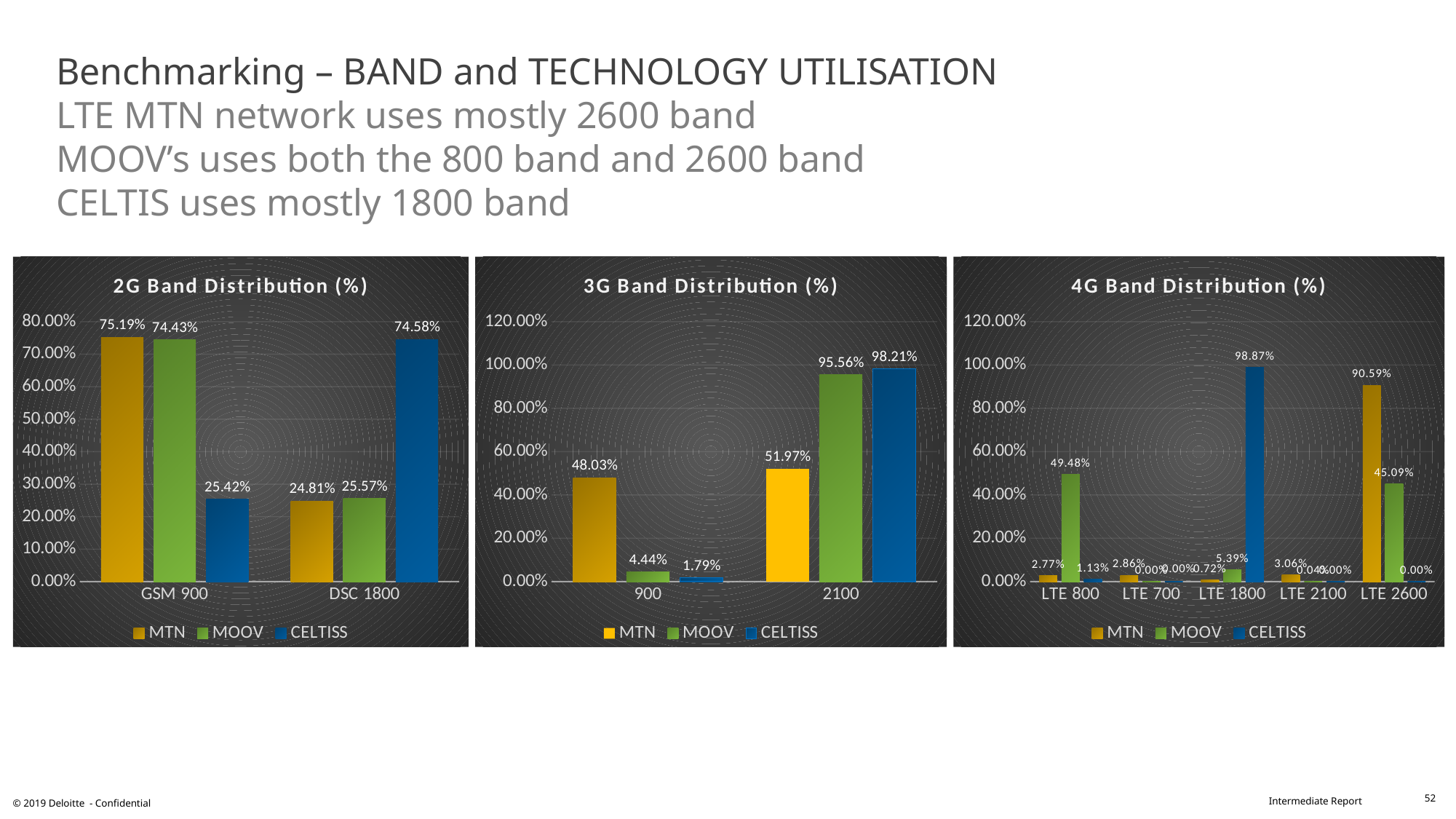
In the 2G Band Distribution (%) chart, which operator has the lowest value on GSM 900? CELTISS What type of chart is the 2G Band Distribution (%) chart? Bar chart In the 4G Band Distribution (%) chart, what is the value for MOOV on LTE 800? 49.48% In the 4G Band Distribution (%) chart, which is larger on LTE 2600: MTN or MOOV? MTN In the 4G Band Distribution (%) chart, what is the value for CELTISS on LTE 1800? 98.87% In the 3G Band Distribution (%) chart, which operator has the highest value on 2100? CELTISS How many series does the legend of the 3G Band Distribution (%) chart list? 3 In the 3G Band Distribution (%) chart, what is the difference between CELTISS and MOOV on 2100? 2.65% In the 4G Band Distribution (%) chart, how many band categories are shown on the x axis? 5 In the 3G Band Distribution (%) chart, what is the value for MTN on 900? 48.03% In the 2G Band Distribution (%) chart, what is the value for CELTISS on DSC 1800? 74.58% In the 2G Band Distribution (%) chart, what is the value for MTN on GSM 900? 75.19%